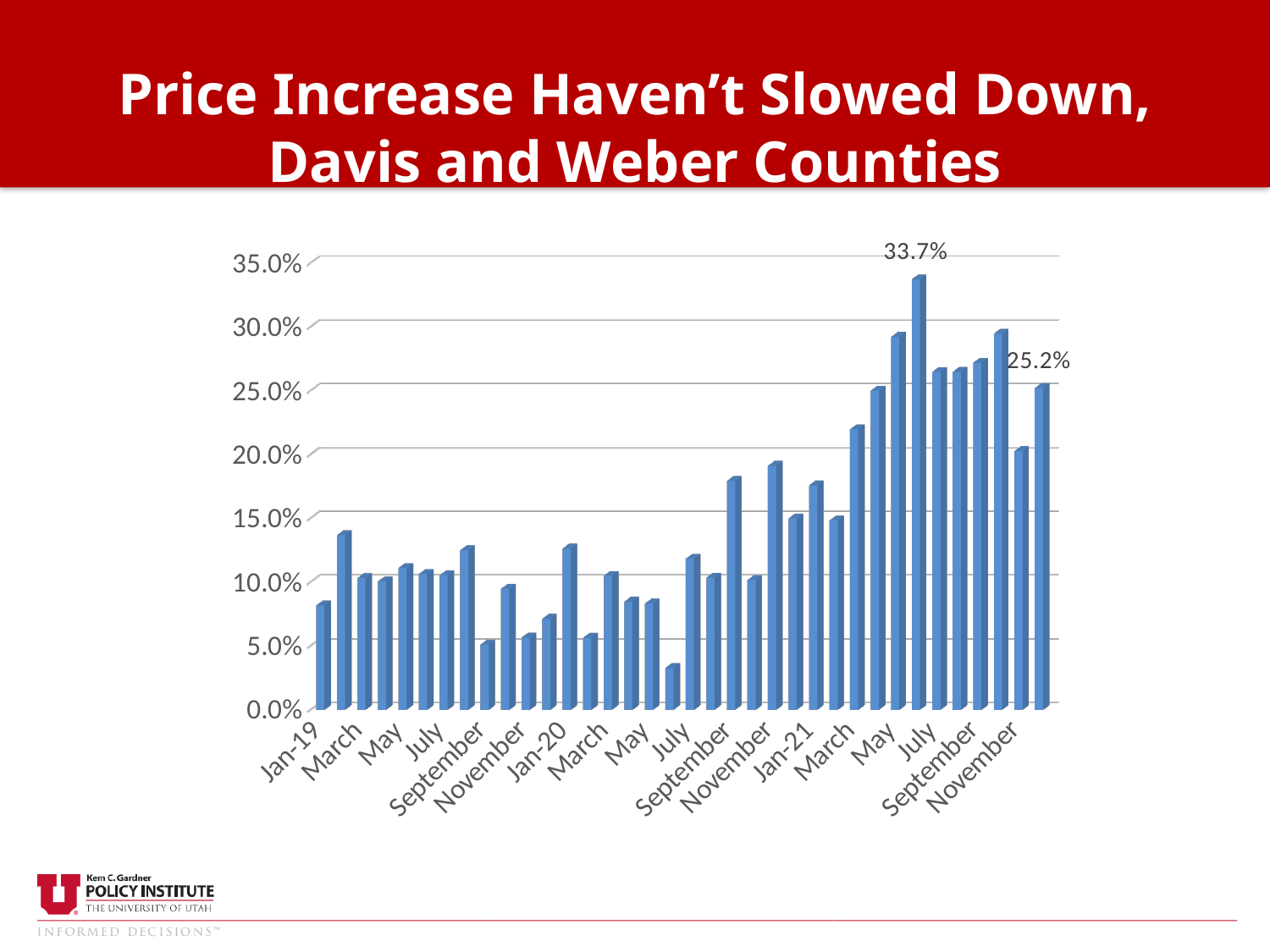
What value is labeled on the final bar (November 2021)? 25.2% What is the title of the slide? Price Increase Haven't Slowed Down, Davis and Weber Counties Is the value for Jan-19 greater or less than 10.0%? less What type of chart is shown on the slide? Bar chart Which is larger: the labeled peak value or the final bar's labeled value? The peak value, 33.7% How many bars have data labels printed on the chart? 2 What is the difference between the labeled peak value of 33.7% and the final labeled value of 25.2%? 8.5 percentage points Is the lowest bar on the chart greater or less than 5.0%? less Do the values generally rise or fall from 2019 to 2021? Rise What is the highest value labeled on the chart? 33.7% Is the value for Jan-20 greater or less than 10.0%? greater